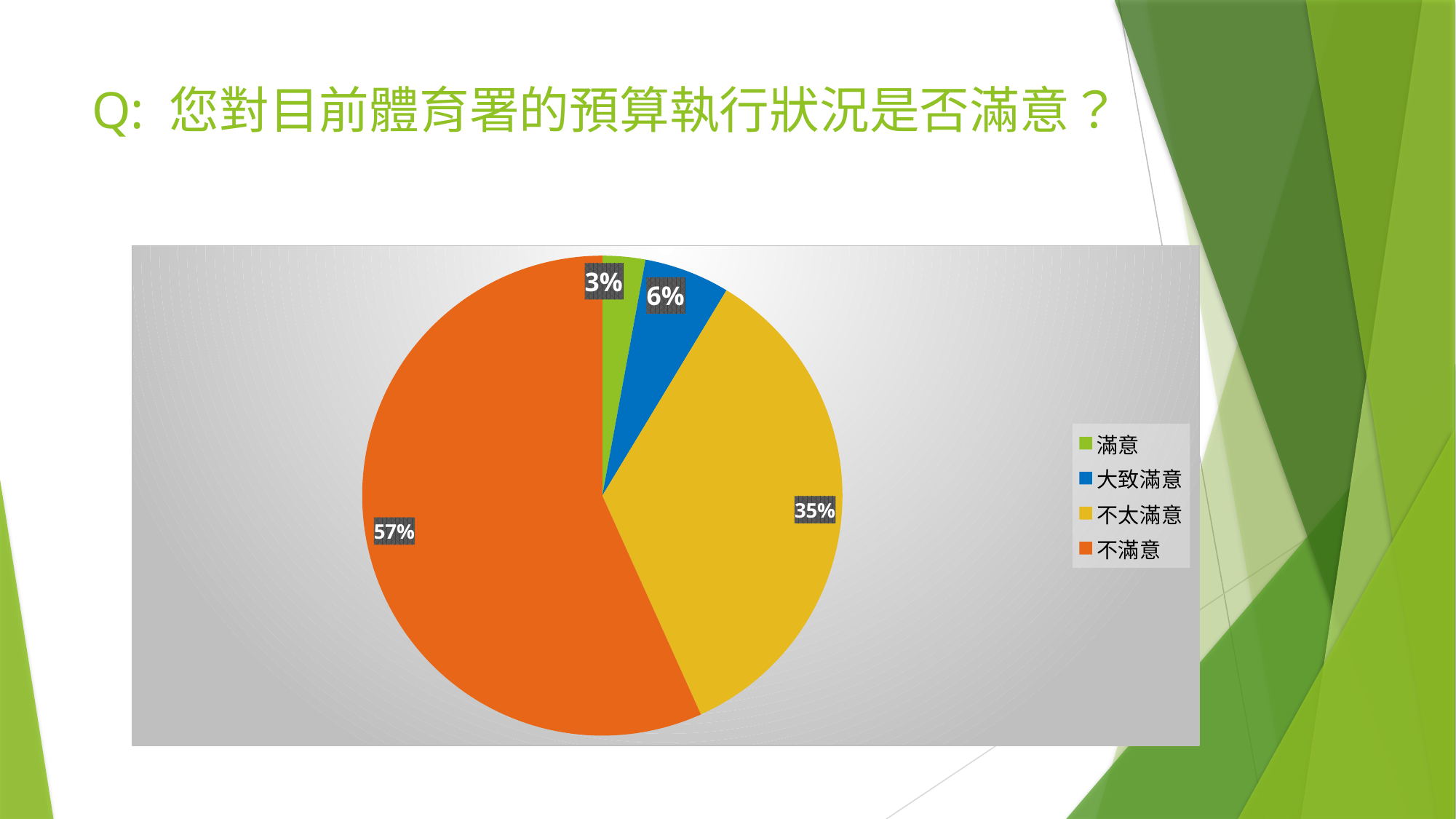
Which category has the smallest slice of the pie? 滿意 What share of the pie does 不滿意 represent? 57% What is the value shown for 滿意? 3% Which is larger, the share for 不太滿意 or the share for 大致滿意? 不太滿意 What is the difference between the shares for 不滿意 and 不太滿意? 22% What colour is the slice for 不太滿意? Yellow What is the difference between the shares for 大致滿意 and 滿意? 3% What kind of chart is shown on the slide? Pie chart How many categories does the pie chart have? 4 What share of the pie does 不太滿意 represent? 35% What is the value shown for 大致滿意? 6% Which category has the largest slice of the pie? 不滿意